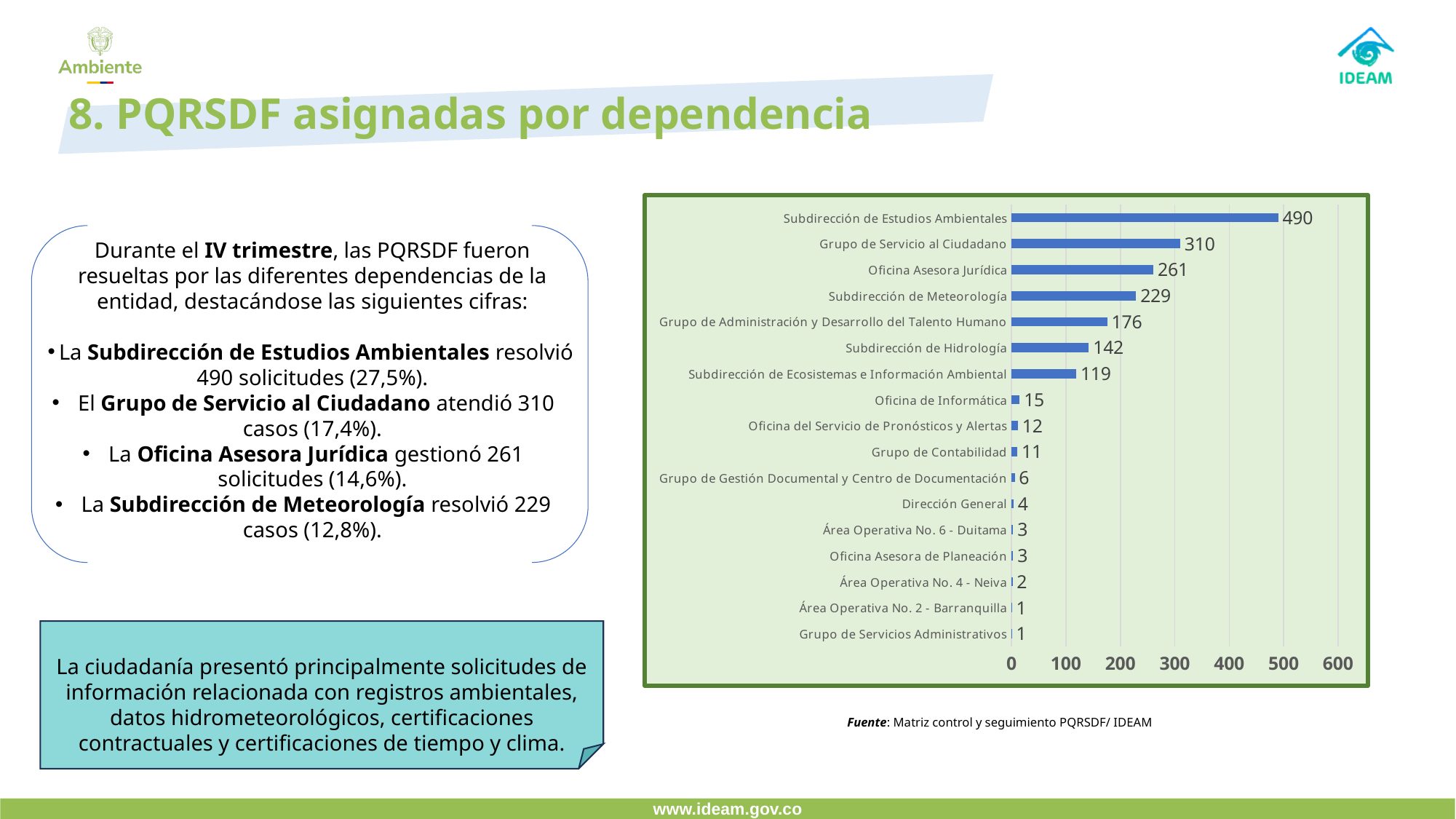
What is the difference between the values for Subdirección de Estudios Ambientales and Subdirección de Meteorología? 261 How many dependencies are shown in the chart? 17 What value is shown for Subdirección de Hidrología? 142 What is the difference between the values for Grupo de Servicio al Ciudadano and Oficina Asesora Jurídica? 49 Which dependency has the highest value in the chart? Subdirección de Estudios Ambientales What is the highest value shown on the horizontal axis of the chart? 600 Which has a larger value, Subdirección de Meteorología or Grupo de Administración y Desarrollo del Talento Humano? Subdirección de Meteorología What value is shown for Dirección General? 4 What kind of chart is shown on the slide? bar chart What value is shown for Oficina del Servicio de Pronósticos y Alertas? 12 Is the value for Subdirección de Ecosistemas e Información Ambiental greater or less than 200? less What value is shown for Subdirección de Estudios Ambientales? 490